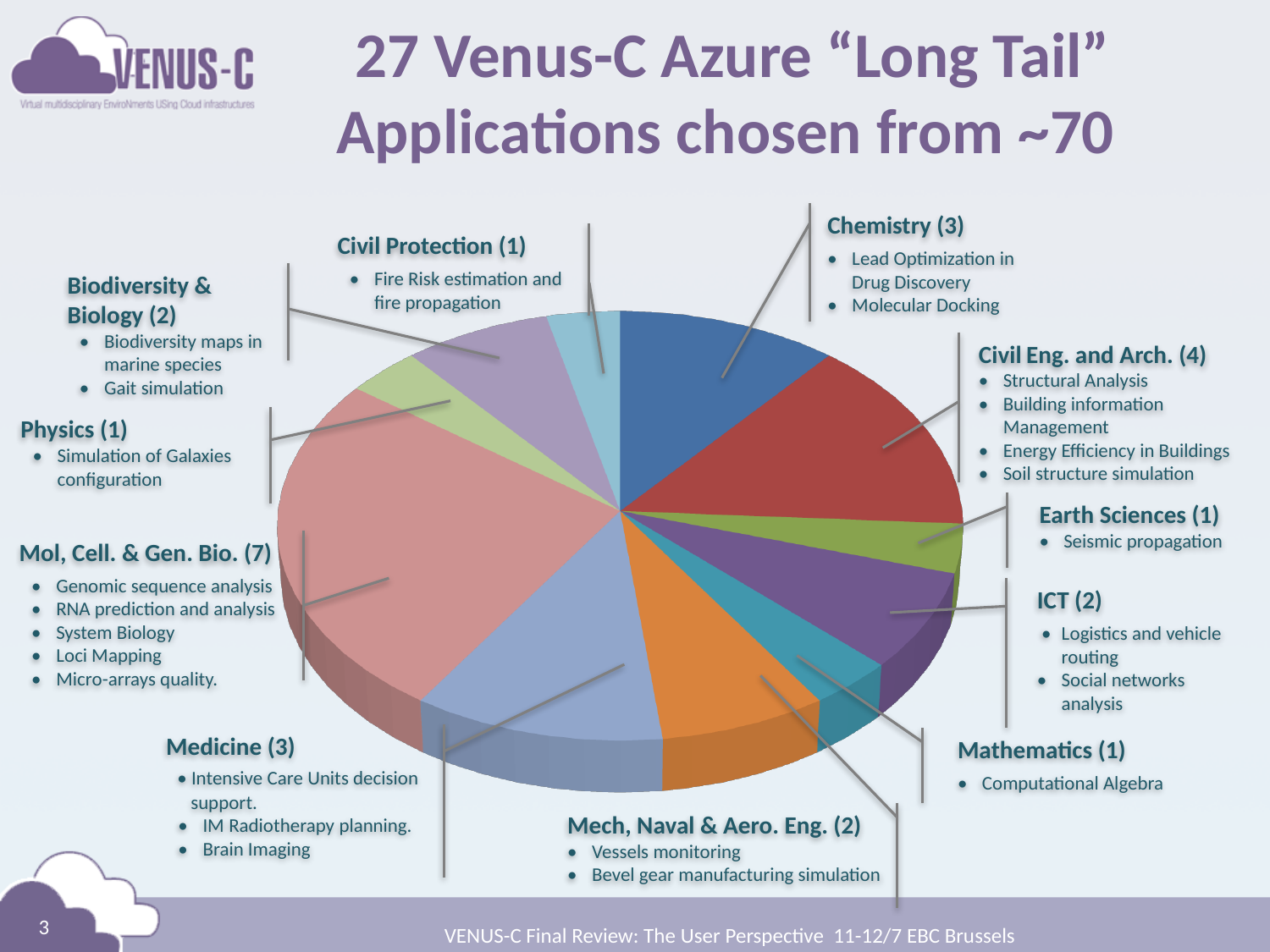
How many application categories are shown in the pie chart? 11 How many applications are in the Mol, Cell. & Gen. Bio. category? 7 How many applications are in the ICT category? 2 What is the difference in the number of applications between Mol, Cell. & Gen. Bio. and Civil Eng. and Arch.? 3 Which category has more applications, Chemistry or Civil Eng. and Arch.? Civil Eng. and Arch. How many applications are in the Chemistry category? 3 What is the total number of applications across all categories in the pie chart? 27 What type of chart is shown on the slide? Pie chart How many applications are in the Civil Eng. and Arch. category? 4 Which category has the largest number of applications? Mol, Cell. & Gen. Bio. What is the title of the slide containing the pie chart? 27 Venus-C Azure "Long Tail" Applications chosen from ~70 Which category has more applications, Medicine or Mathematics? Medicine